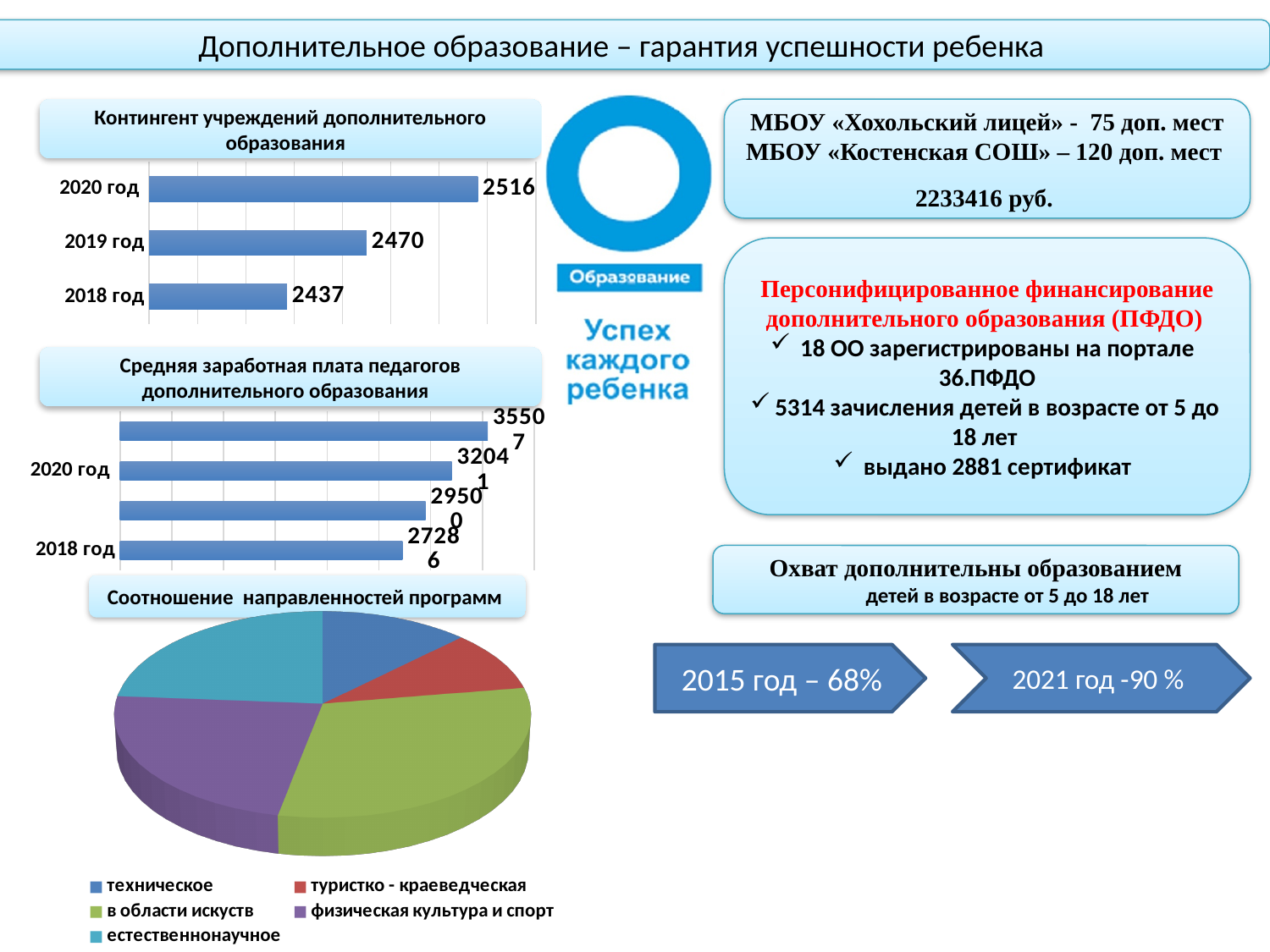
In the chart 'Контингент учреждений дополнительного образования', what is the value for 2020 год? 2516 How many categories does the legend of the pie chart 'Соотношение направленностей программ' list? 5 In the chart 'Средняя заработная плата педагогов дополнительного образования', what is the value for 2018 год? 27286 In the chart 'Контингент учреждений дополнительного образования', what is the value for 2018 год? 2437 In the pie chart 'Соотношение направленностей программ', which category has the largest slice? в области искуств In the chart 'Контингент учреждений дополнительного образования', what is the difference between the values for 2020 год and 2019 год? 46 How many years are shown in the chart 'Контингент учреждений дополнительного образования'? 3 In the chart 'Контингент учреждений дополнительного образования', do the values rise or fall from 2018 год to 2020 год? rise In the chart 'Контингент учреждений дополнительного образования', which year has the lowest value? 2018 год What kind of chart is 'Контингент учреждений дополнительного образования'? bar chart In the chart 'Контингент учреждений дополнительного образования', which year has the highest value? 2020 год How many bars are shown in the chart 'Средняя заработная плата педагогов дополнительного образования'? 4